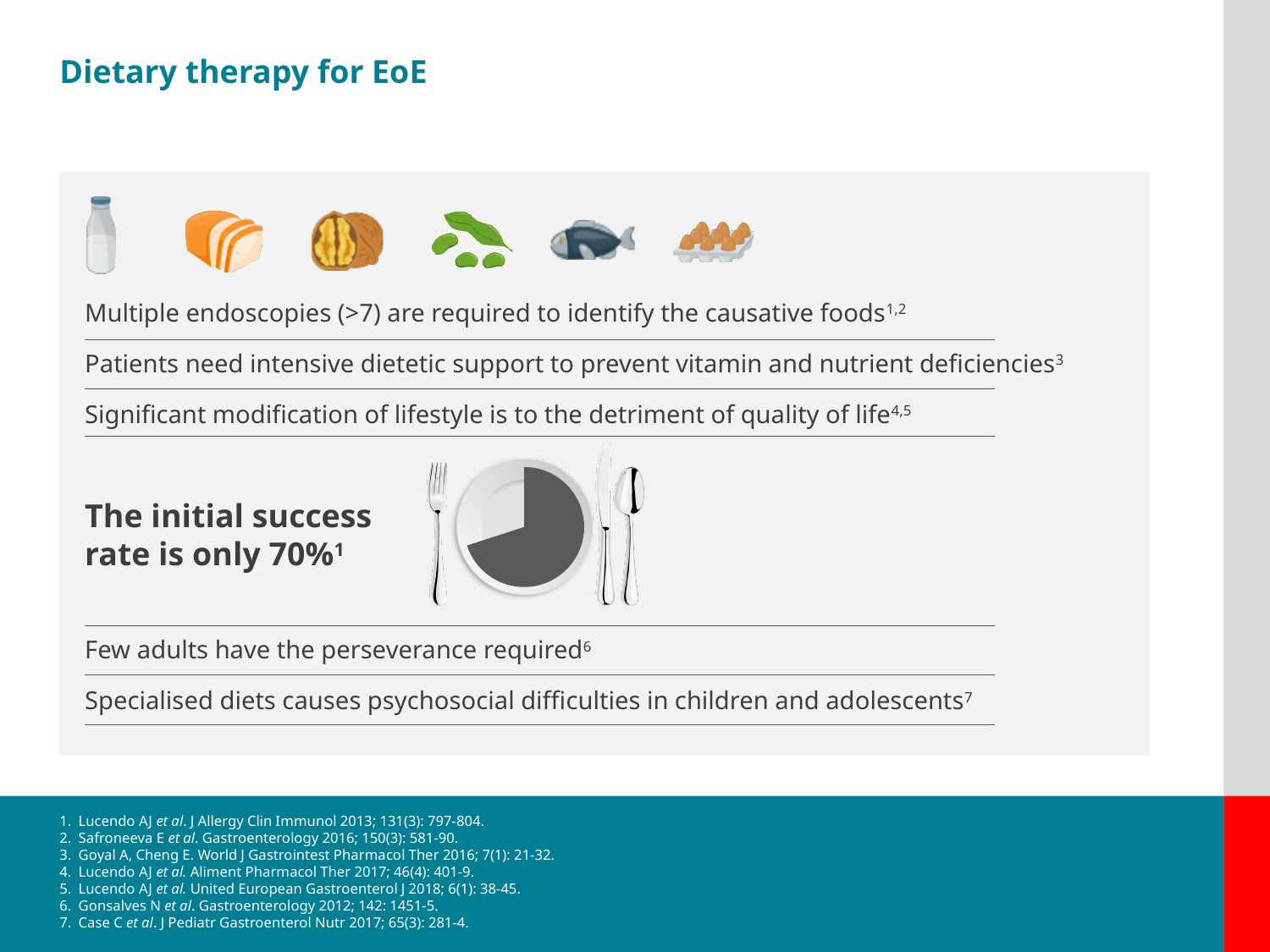
Is the share of the dark slice in the pie chart on the plate greater or less than 50%? greater What share of the pie chart on the plate does the dark slice represent, according to the slide text? 70% In the pie chart on the plate, which slice is larger, the dark one or the light one? the dark one How many slices does the pie chart on the plate have? 2 What does the pie chart on the plate illustrate, according to the text beside it? The initial success rate is only 70% What kind of chart is shown on the plate in the middle of the slide? pie chart